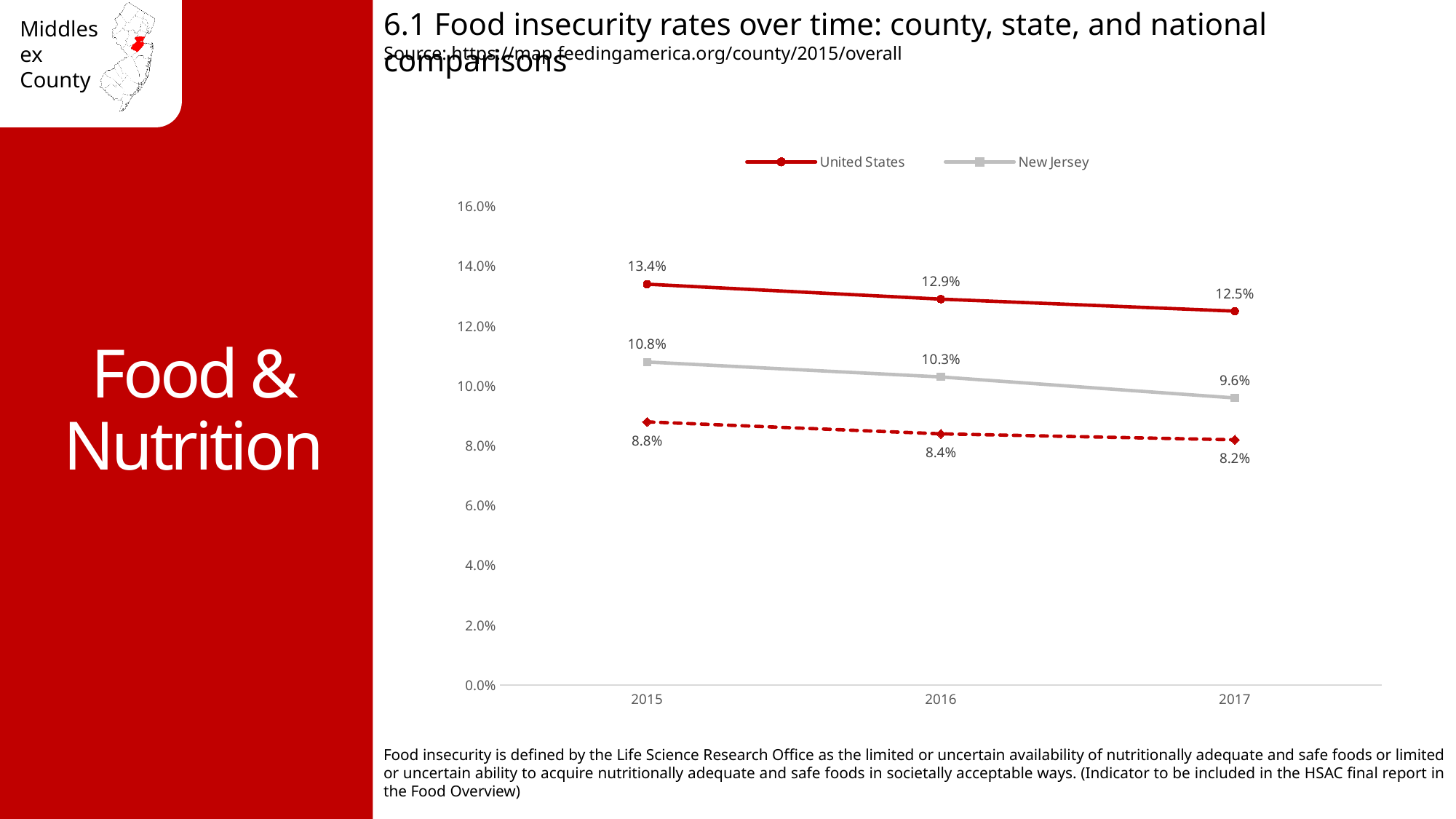
What kind of chart is shown on the slide? line chart What is the New Jersey food insecurity rate in 2017? 9.6% In which year is the United States rate highest? 2015 What value does the dashed red line show for 2016? 8.4% How many years are shown on the x axis? 3 What is the United States food insecurity rate in 2015? 13.4% What is the difference between the New Jersey rates in 2015 and 2016? 0.5% In 2016, which is larger: the United States rate or the New Jersey rate? United States By how much did the United States rate fall from 2015 to 2017? 0.9% How many series does the legend list? 2 In which year is the New Jersey rate lowest? 2017 Is the New Jersey value for 2015 greater or less than 10.0%? greater